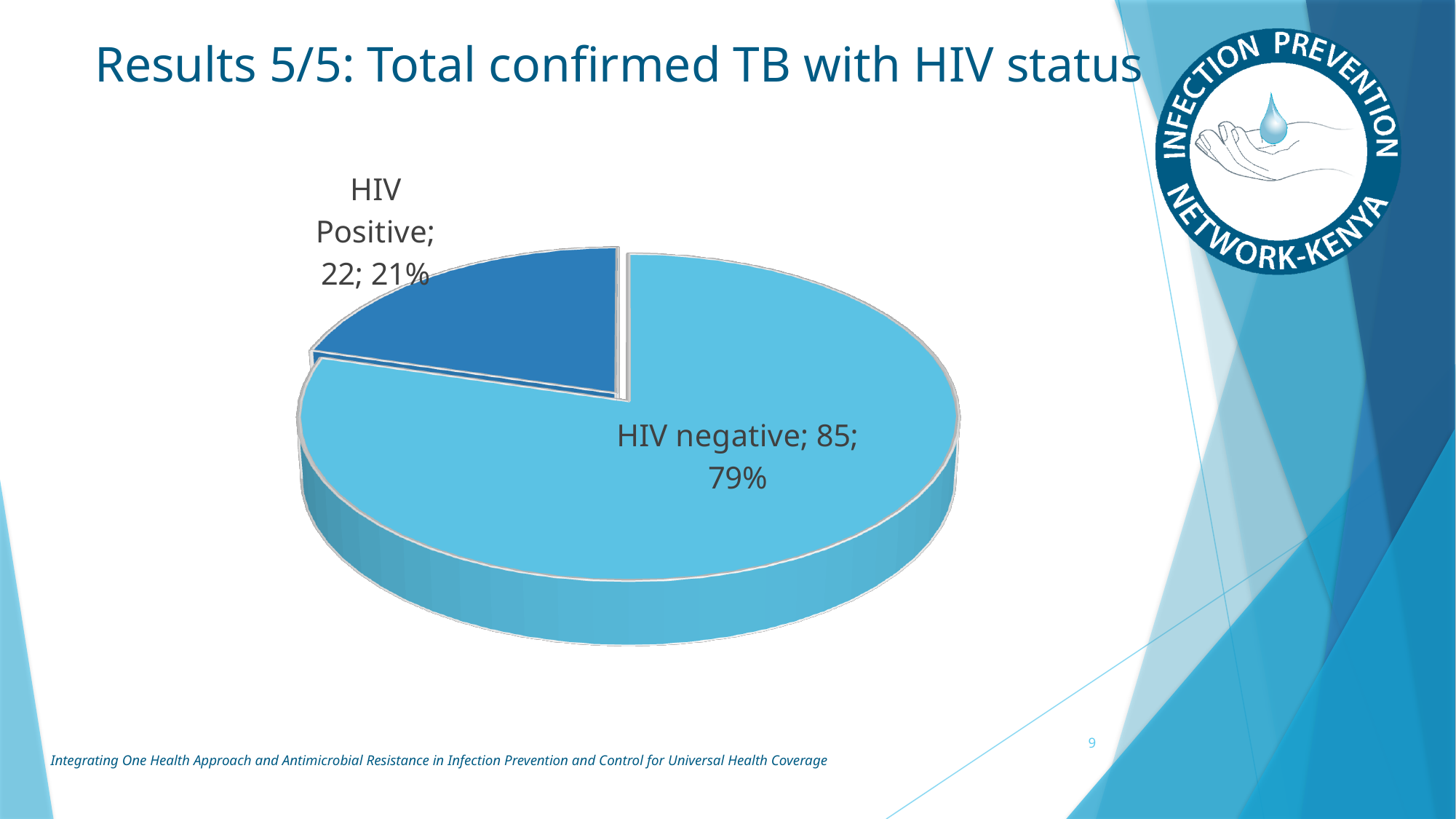
What is the total of the two slices in the pie chart? 107 Which is larger, the HIV negative count or the HIV Positive count? HIV negative What percentage share does the HIV Positive slice represent? 21% What is the difference between the HIV negative count and the HIV Positive count? 63 Which category has the largest slice? HIV negative What kind of chart is shown on the slide? Pie chart What is the count for HIV Positive? 22 Which category has the smallest slice? HIV Positive How many slices does the pie chart have? 2 What is the count for HIV negative? 85 What percentage share does the HIV negative slice represent? 79% What is the title of the slide containing the chart? Results 5/5: Total confirmed TB with HIV status